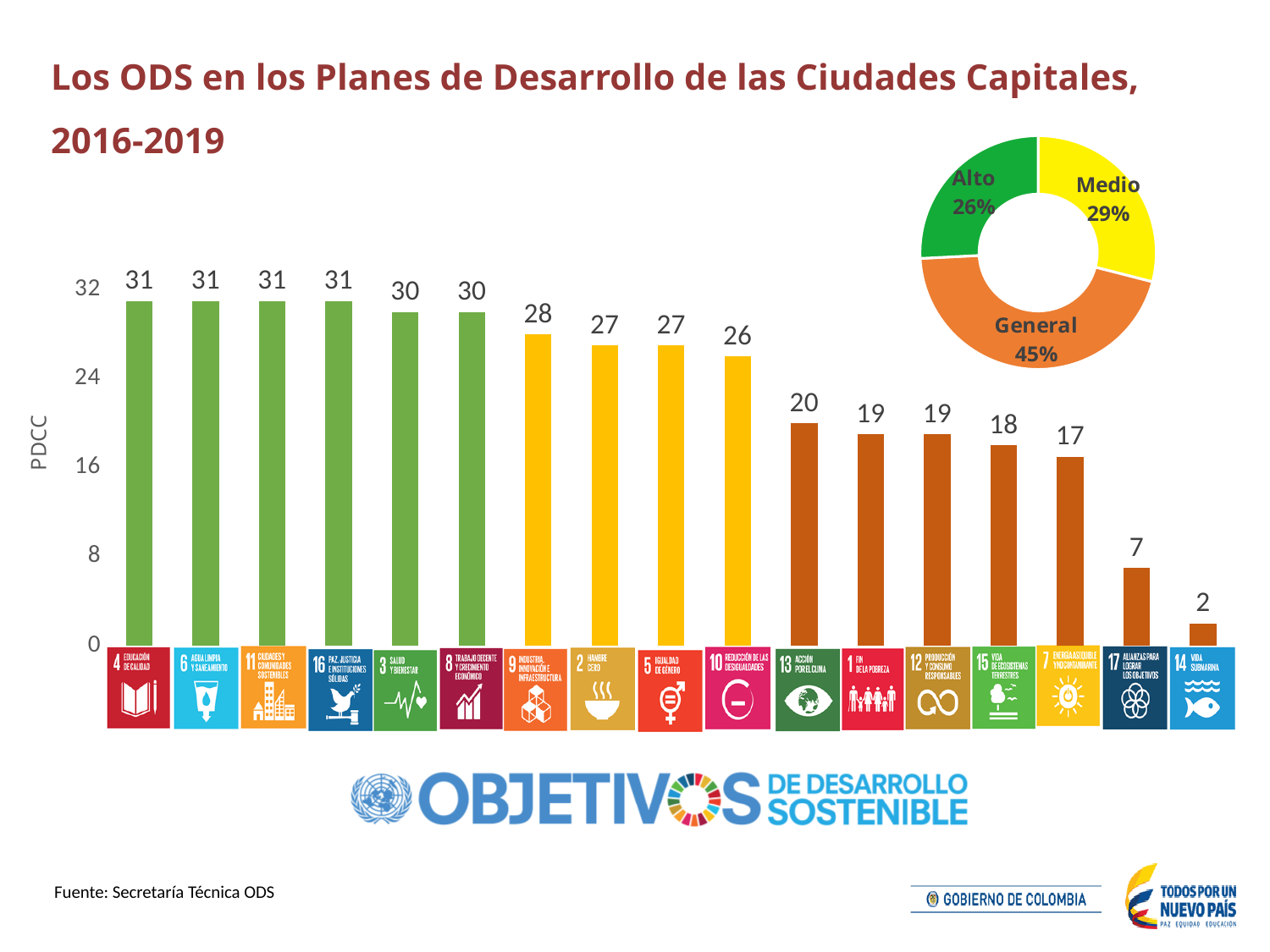
In the bar chart, what is the difference between the value for ODS 10 Reducción de las desigualdades and ODS 14 Vida submarina? 24 In the bar chart, what is the PDCC value for ODS 13 Acción por el clima? 20 How many bars are shown in the bar chart? 17 In the donut chart, which segment is the smallest? Alto What kind of chart is the chart on the left showing PDCC values? bar chart In the bar chart, what is the value for ODS 9 Industria, innovación e infraestructura? 28 What is the label on the vertical axis of the bar chart? PDCC In the bar chart, what is the value for ODS 17 Alianzas para lograr los objetivos? 7 In the bar chart, which is larger: the value for ODS 7 Energía asequible y no contaminante or ODS 15 Vida de ecosistemas terrestres? ODS 15 Vida de ecosistemas terrestres In the donut chart, what share does General have? 45% In the bar chart, which ODS has the lowest value? ODS 14 Vida submarina In the bar chart, is the value for ODS 1 Fin de la pobreza greater or less than 24? less